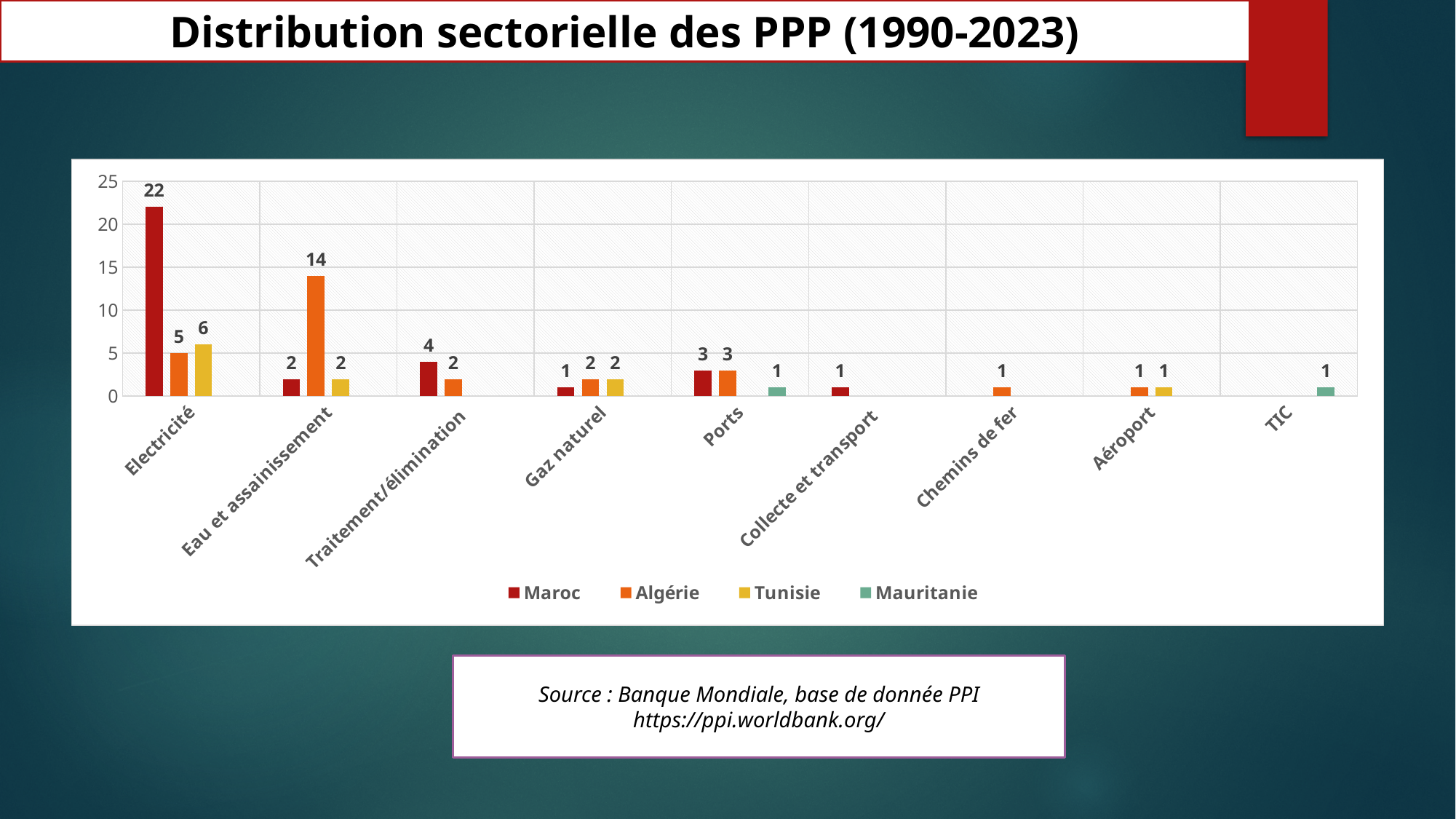
What is the value for Maroc in the Electricité category? 22 In the Traitement/élimination category, which is larger, the value for Maroc or the value for Algérie? Maroc What is the value for Tunisie in the Electricité category? 6 What is the value for Algérie in the Eau et assainissement category? 14 What kind of chart is shown on the slide? Bar chart What is the value for Mauritanie in the TIC category? 1 Which category has the highest value for Algérie? Eau et assainissement How many series does the legend list? 4 Which category has the highest value for Maroc? Electricité What is the difference between the Maroc value and the Algérie value in the Electricité category? 17 How many sector categories are shown on the x axis? 9 Is the value for Algérie in the Eau et assainissement category greater or less than 10? greater